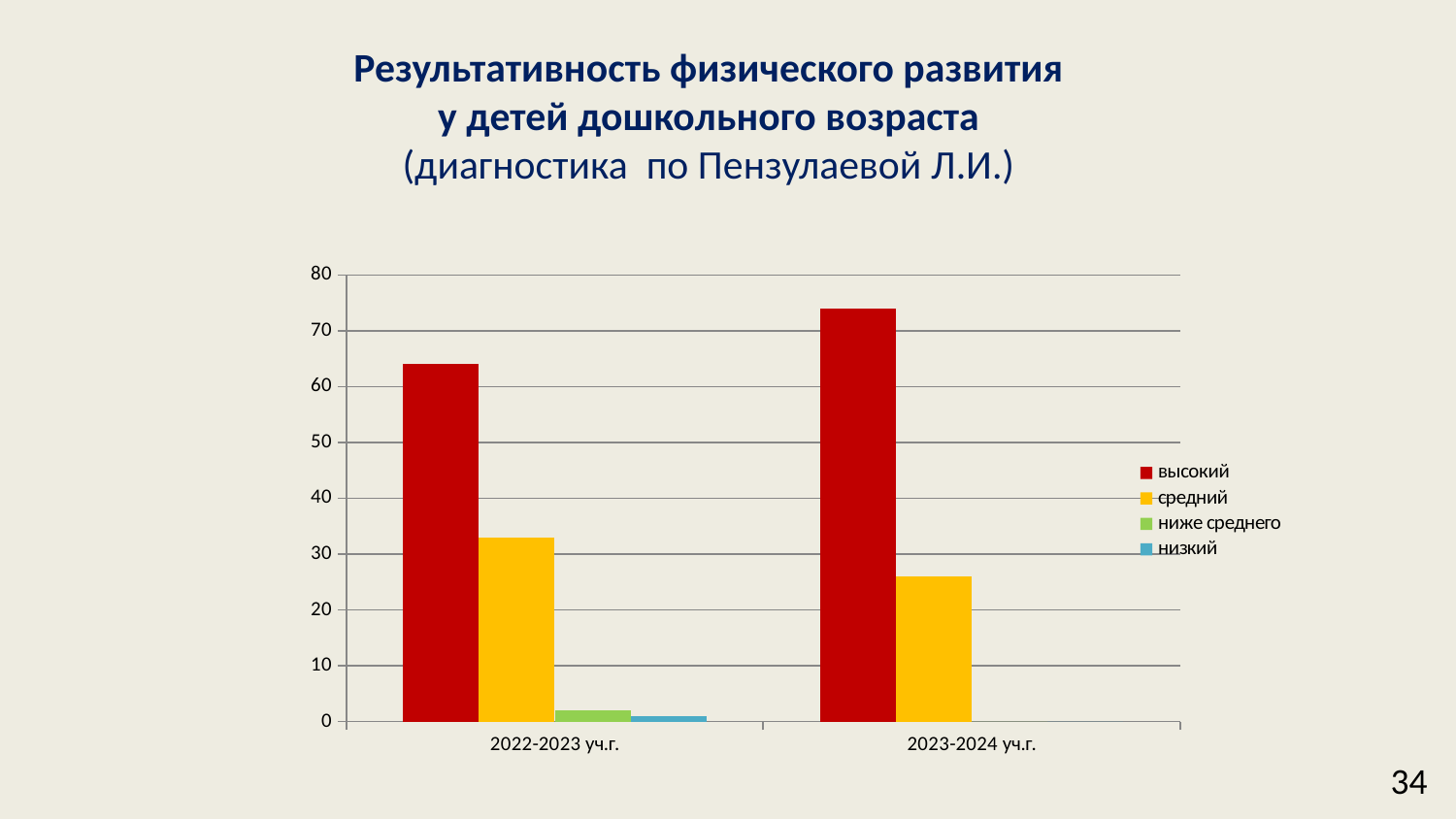
Is the value for высокий in 2023-2024 уч.г. greater or less than 70? greater What kind of chart is shown on the slide? bar chart Which is larger: the value for высокий in 2022-2023 уч.г. or in 2023-2024 уч.г.? 2023-2024 уч.г. Is the value for высокий in 2022-2023 уч.г. greater or less than 70? less How many series does the legend list? 4 Is the value for средний in 2022-2023 уч.г. greater or less than 30? greater Which series is shown in red in the legend? высокий Which series has the lowest visible value for 2022-2023 уч.г.? низкий Which series has the highest value for 2022-2023 уч.г.? высокий Does the value for средний rise or fall from 2022-2023 уч.г. to 2023-2024 уч.г.? fall How many categories (academic years) are shown on the x axis? 2